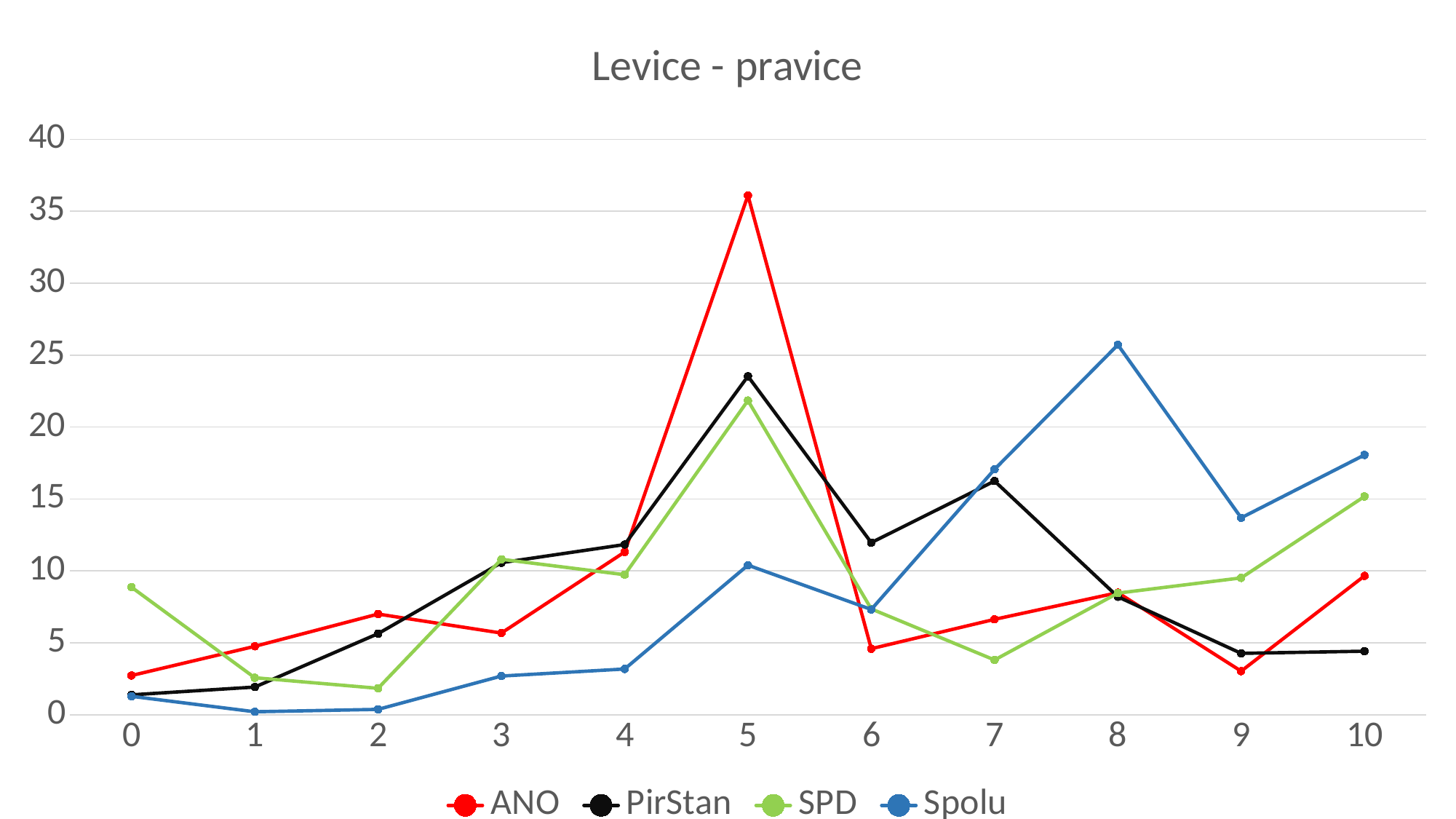
At which x value does the ANO series reach its highest point? 5 Is the value for ANO at x = 5 greater or less than 30? greater What is the title of the chart? Levice - pravice How many points are plotted along the x axis for each series? 11 What kind of chart is shown on the slide? line chart At which x value does the Spolu series reach its highest point? 8 Is the value for PirStan at x = 7 greater or less than 15? greater At x = 5, which series has the higher value, ANO or PirStan? ANO How many series does the legend list? 4 Is the value for Spolu at x = 8 greater or less than 20? greater Between x = 6 and x = 8, does the Spolu series rise or fall? rise At x = 10, which series has the highest value? Spolu